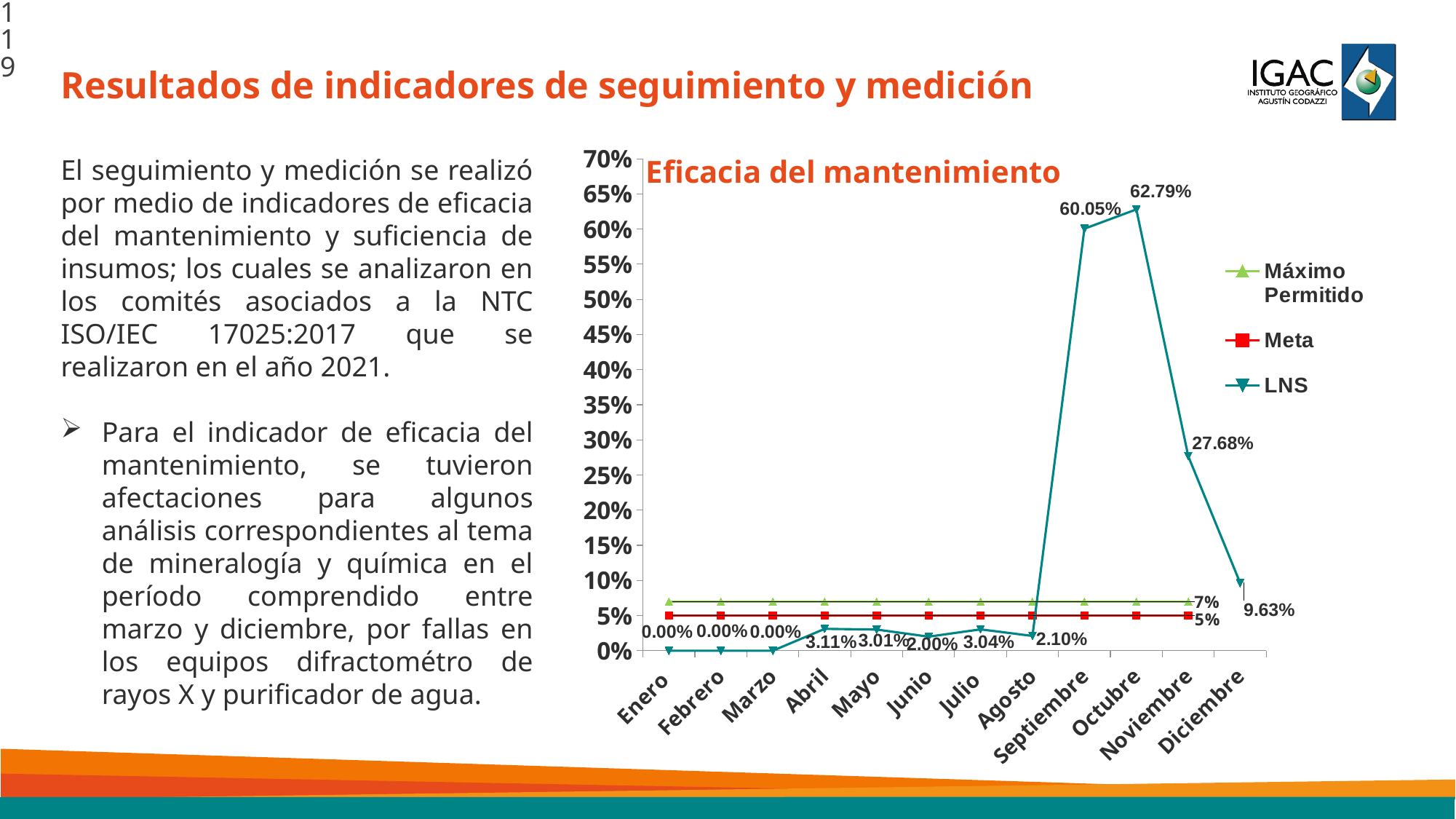
How many months are plotted along the x axis? 12 What is the LNS value for Noviembre? 27.68% What is the LNS value for Octubre? 62.79% How many series does the chart legend list? 3 Does the LNS series rise or fall from Octubre to Diciembre? Fall In which month does the LNS series reach its highest value? Octubre What is the title of the chart? Eficacia del mantenimiento Which is larger, the LNS value for Diciembre or the LNS value for Julio? Diciembre What is the difference between the LNS values for Octubre and Septiembre? 2.74% What type of chart is shown on the slide? Line chart What is the LNS value for Abril? 3.11% What constant value does the Meta series hold across all months? 5%